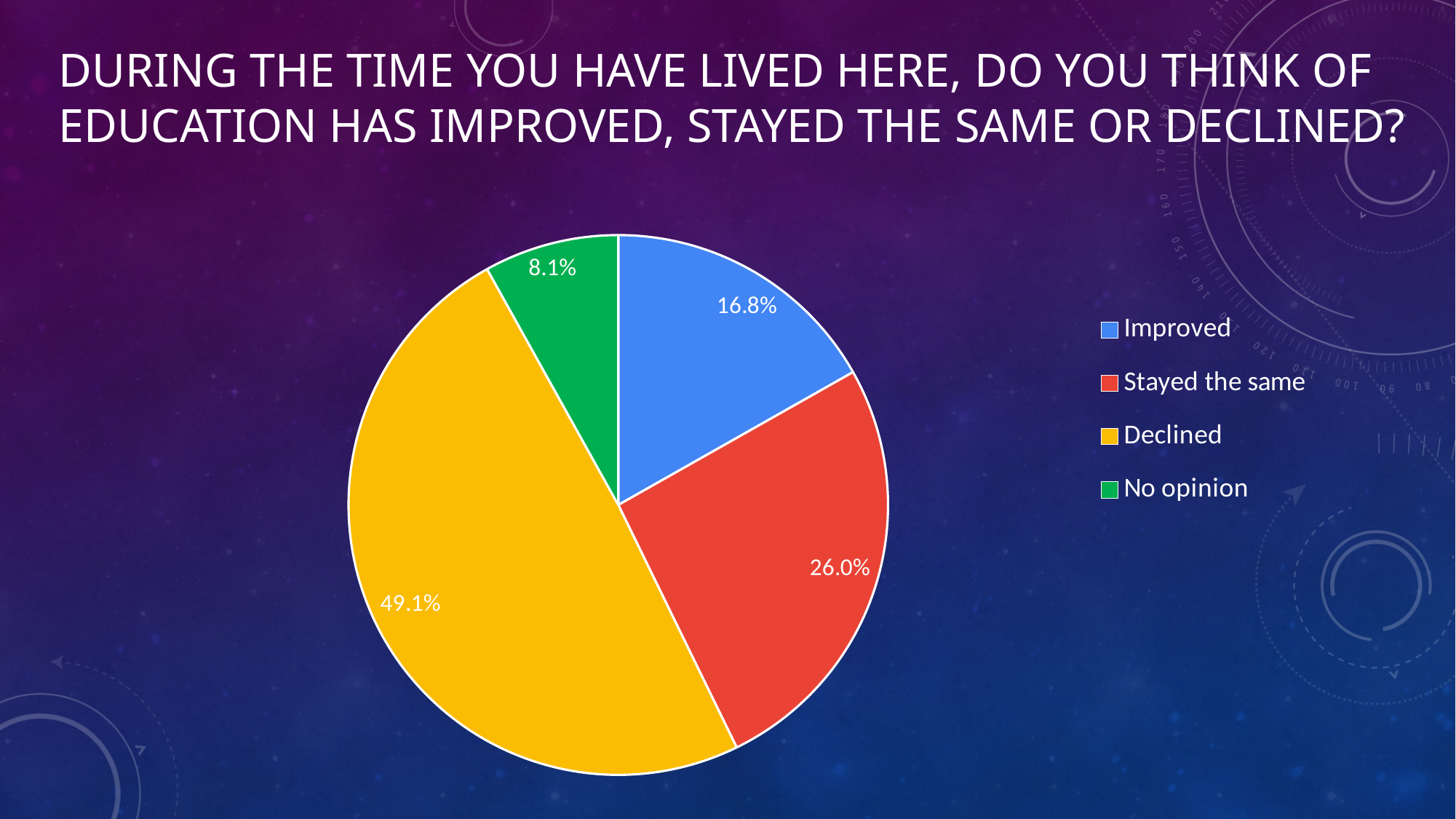
Which response has the largest share of the pie? Declined What colour represents the Declined slice? Yellow What type of chart is shown on the slide? Pie chart Which is larger, the share for Stayed the same or the share for Improved? Stayed the same What percentage of respondents said education has Improved? 16.8% What is the difference in percentage points between Declined and Stayed the same? 23.1 How many response categories are shown in the pie chart? 4 What is the difference in percentage points between Improved and No opinion? 8.7 Which response has the smallest share of the pie? No opinion What percentage of respondents said education Stayed the same? 26.0% What percentage of respondents had No opinion? 8.1% What percentage of respondents said education has Declined? 49.1%